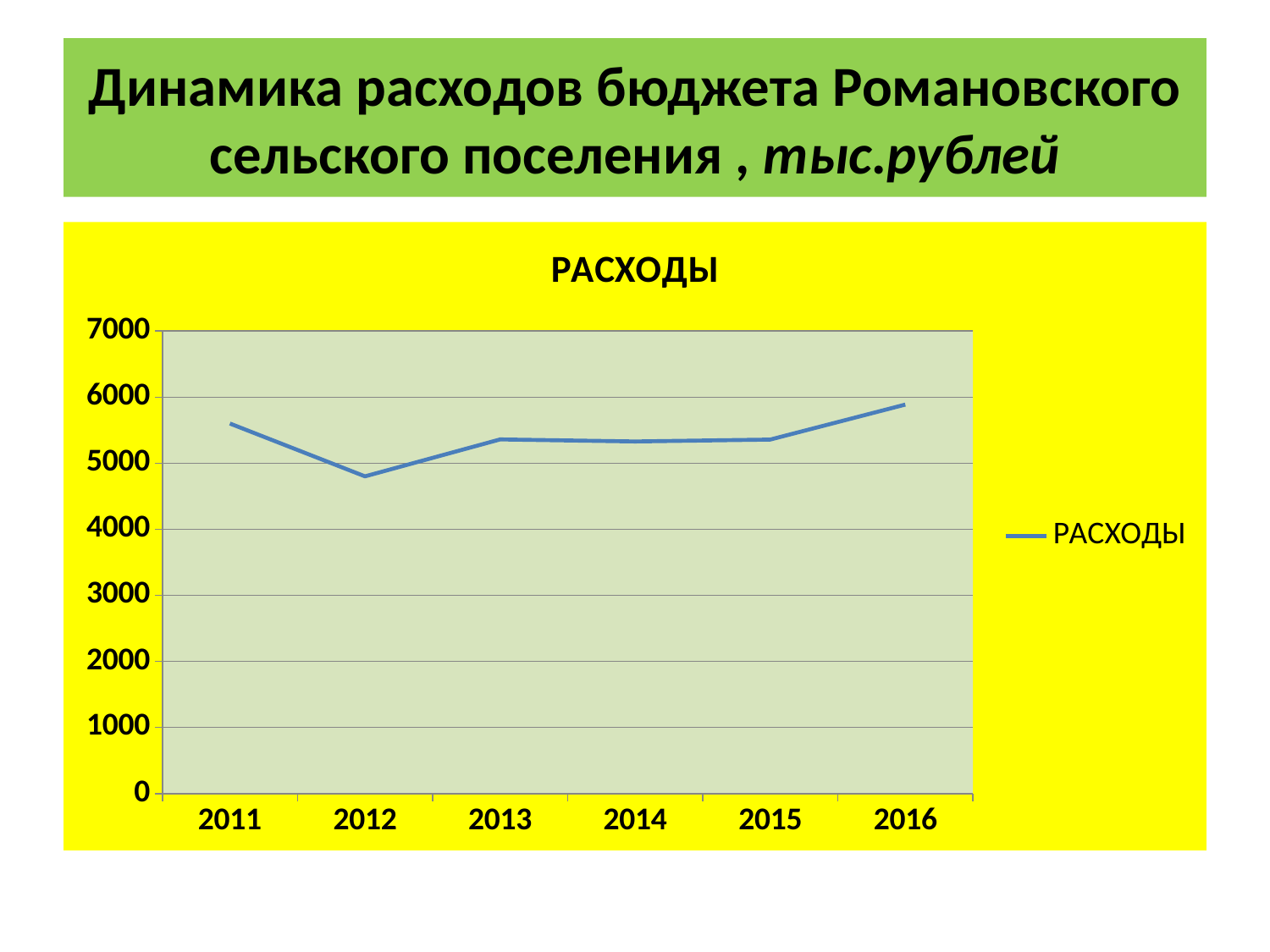
What is the title shown above the chart's plot area? РАСХОДЫ Which year has the larger value, 2011 or 2012? 2011 Which year has the larger value, 2015 or 2016? 2016 Does the value rise or fall from 2012 to 2016? rise In which year is the value of РАСХОДЫ lowest? 2012 What kind of chart is shown on the slide? line chart In which year is the value of РАСХОДЫ highest? 2016 Is the value for 2011 greater or less than 5000? greater How many years are plotted on the x axis of the chart? 6 How many series does the legend of the chart list? 1 Is the value for 2016 greater or less than 6000? less Is the value for 2012 greater or less than 5000? less